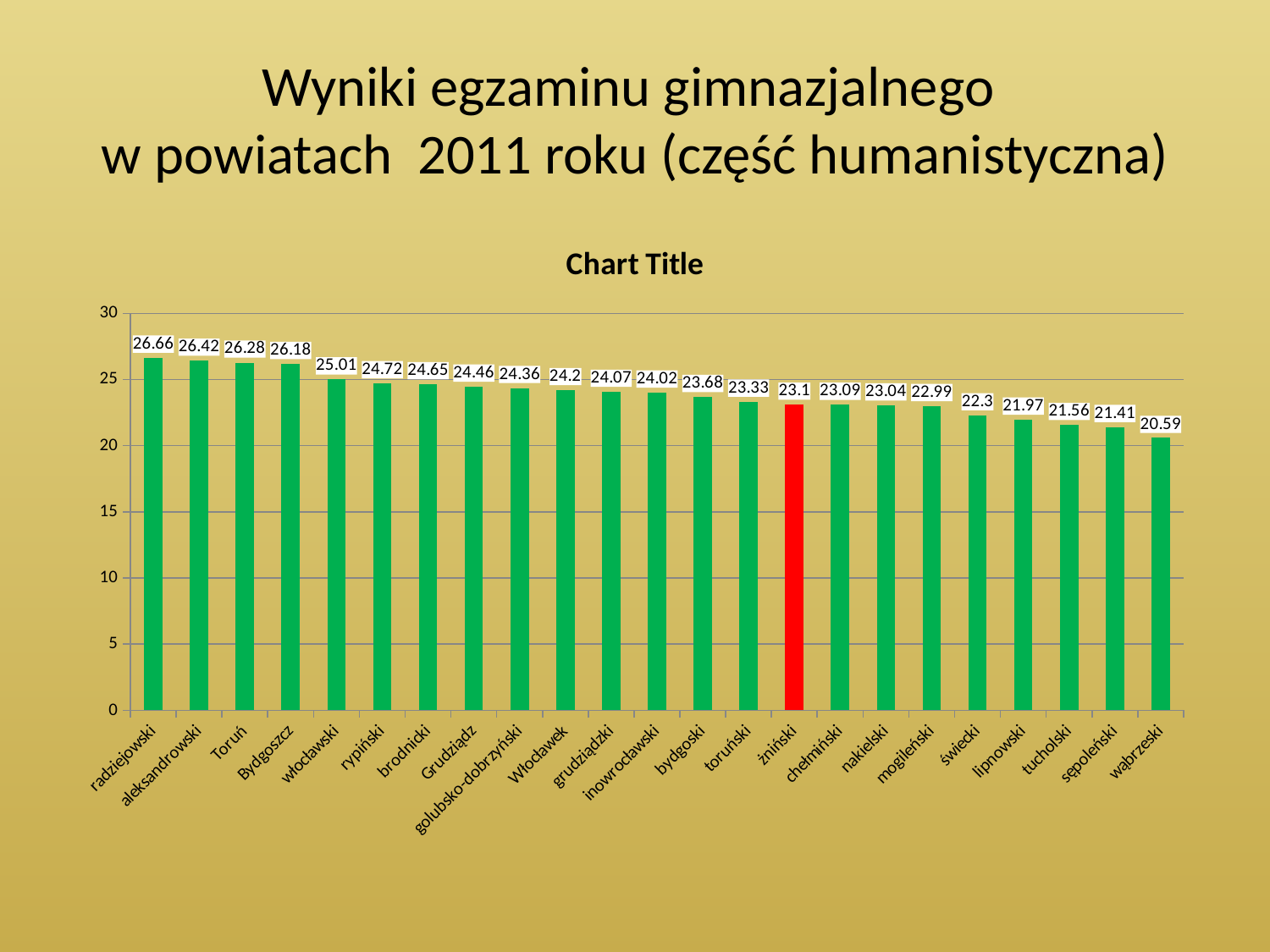
What is the value for golubsko-dobrzyński? 24.36 What is the value for wąbrzeski? 20.59 Which category's bar is coloured red instead of green? żniński What is the difference between the values for Toruń and Bydgoszcz? 0.1 Which is larger, the value for włocławski or the value for świecki? włocławski What kind of chart is shown on the slide? bar chart How many categories are shown on the x axis? 23 Which category has the highest value? radziejowski What is the difference between the values for radziejowski and wąbrzeski? 6.07 What is the value for żniński? 23.1 Which category has the lowest value? wąbrzeski What is the value for radziejowski? 26.66